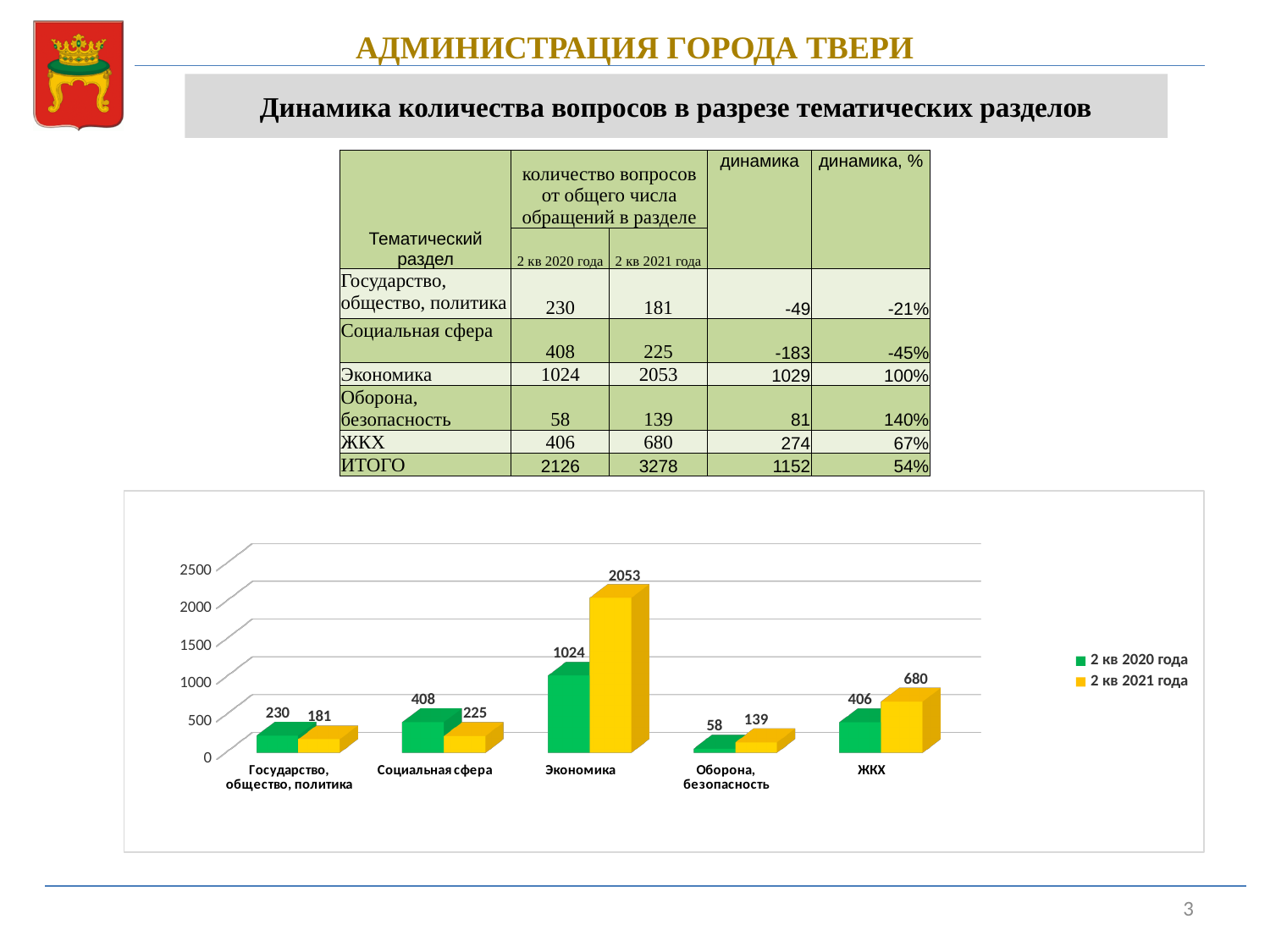
What is the value for Экономика in the 2 кв 2021 года series? 2053 What is the difference between the 2 кв 2021 года and 2 кв 2020 года values for Экономика? 1029 What is the value for ЖКХ in the 2 кв 2020 года series? 406 What kind of chart is shown on the slide? bar chart Which category has the highest value in the 2 кв 2021 года series? Экономика What is the value for Оборона, безопасность in the 2 кв 2020 года series? 58 How many categories are shown on the x axis of the chart? 5 Is the value for ЖКХ in the 2 кв 2021 года series greater or less than 500? greater Which category has the lowest value in the 2 кв 2020 года series? Оборона, безопасность How many series does the chart legend list? 2 What is the difference between the 2 кв 2020 года and 2 кв 2021 года values for Социальная сфера? 183 Which is larger for Государство, общество, политика: the 2 кв 2020 года value or the 2 кв 2021 года value? 2 кв 2020 года